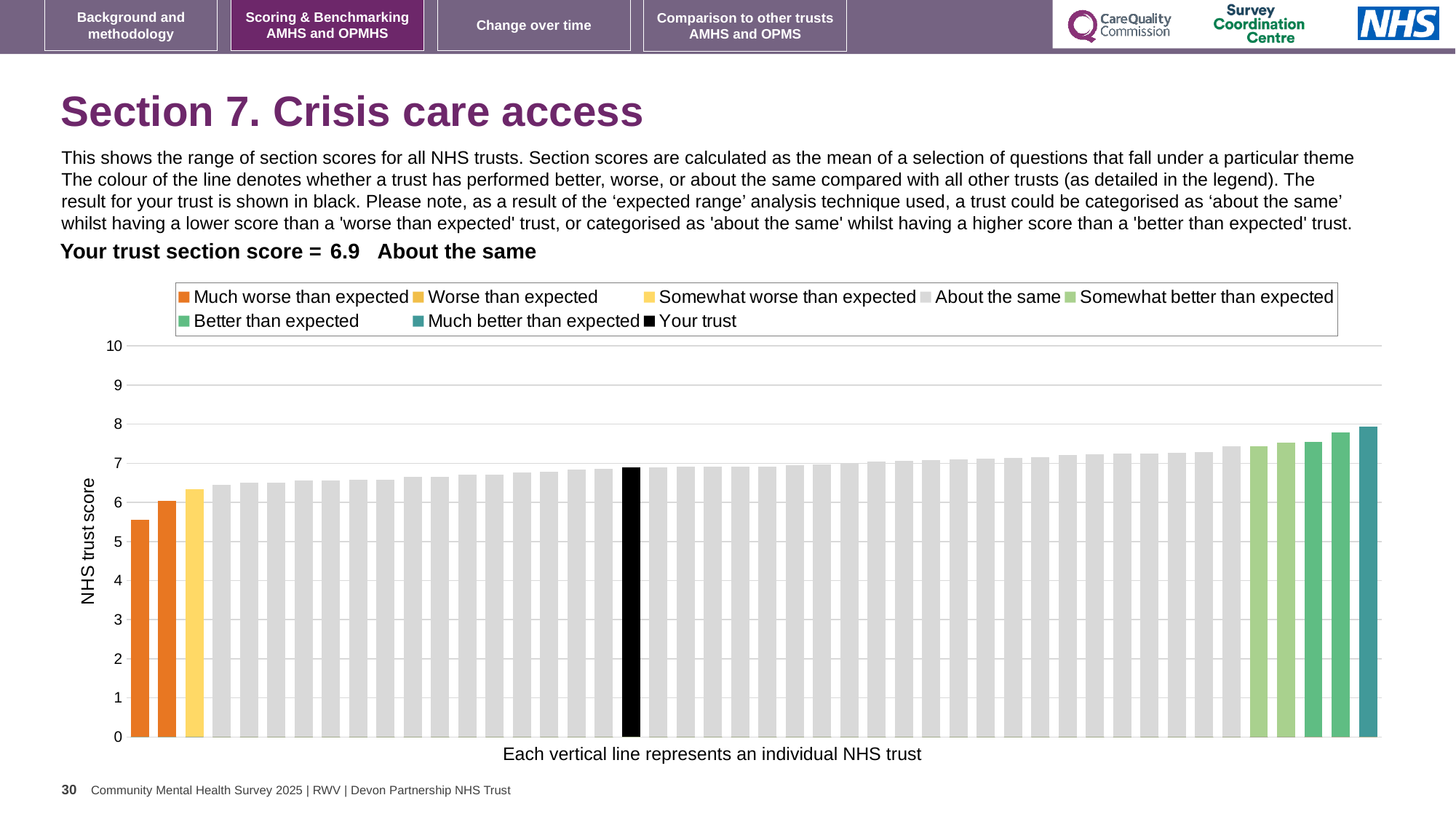
What is the section score for your trust shown on the slide? 6.9 What colour is the bar representing your trust? black Which is larger, the leftmost bar or the rightmost bar? the rightmost bar What is the label on the vertical axis of the chart? NHS trust score How many bars are coloured orange ('Much worse than expected')? 2 Which category is your trust placed in for crisis care access? About the same Do the bar values rise or fall from left to right along the x axis? rise Is the value of the lowest bar in the chart greater or less than 6? less Is the value of the black 'Your trust' bar greater or less than 6? greater Is the value of the highest bar in the chart greater or less than 7? greater What type of chart is shown on the slide? bar chart How many entries does the chart legend list? 8